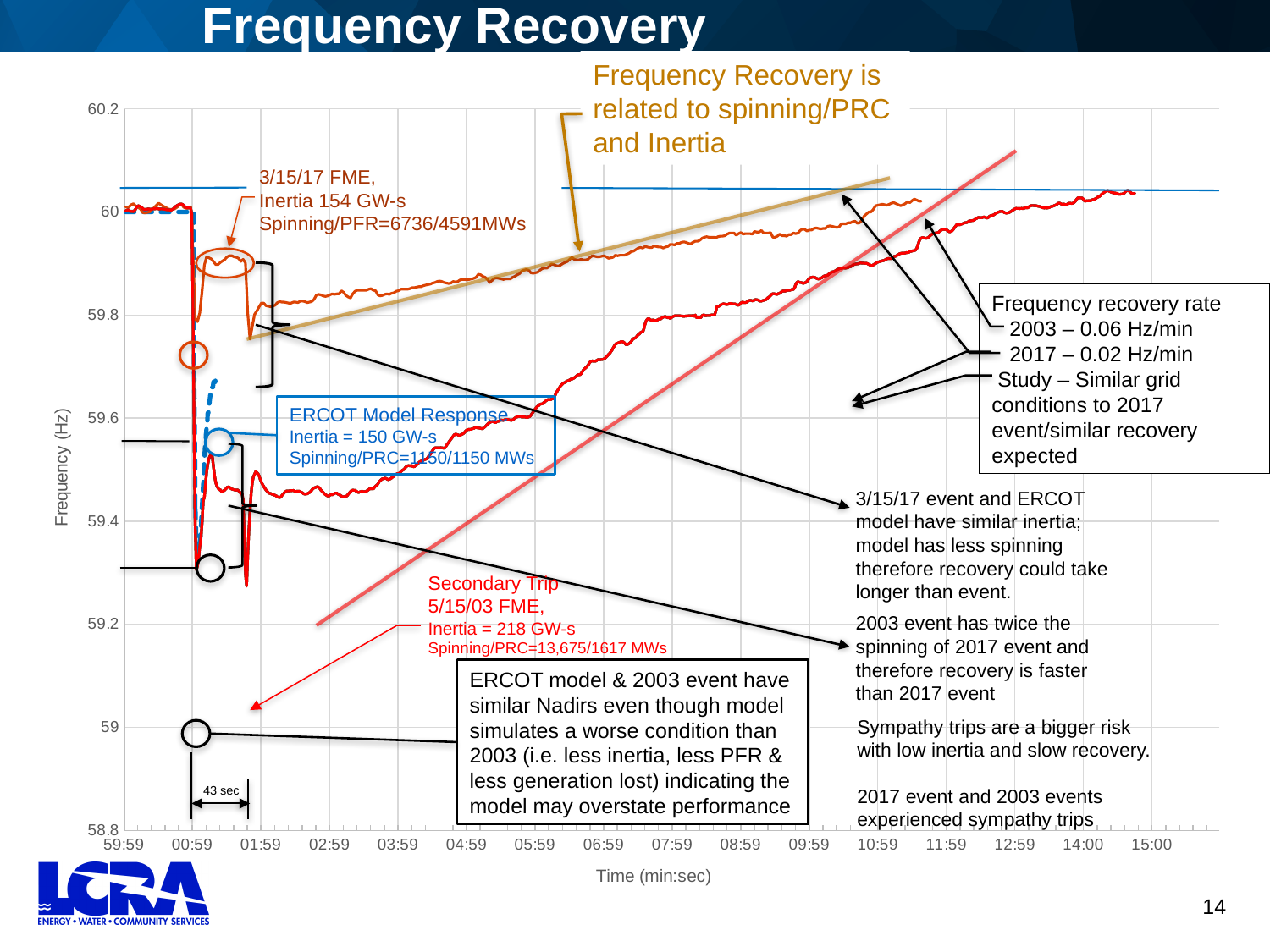
What is the label of the x axis? Time (min:sec) Is the lowest frequency reached by the 3/15/17 FME trace greater or less than 59.6 Hz? greater What inertia value is annotated for the ERCOT Model Response? 150 GW-s What frequency recovery rate is given for the 2017 event? 0.02 Hz/min After the initial drop, does the frequency of the 5/15/03 FME trace rise or fall over time? rise What is the label of the y axis? Frequency (Hz) What inertia value is annotated for the 3/15/17 FME event? 154 GW-s What inertia value is annotated for the 5/15/03 FME event? 218 GW-s What type of chart is shown on the slide? line chart How many frequency traces are plotted on the chart? 3 What frequency recovery rate is given for the 2003 event? 0.06 Hz/min Is the lowest frequency reached by the 5/15/03 FME trace greater or less than 59.4 Hz? less